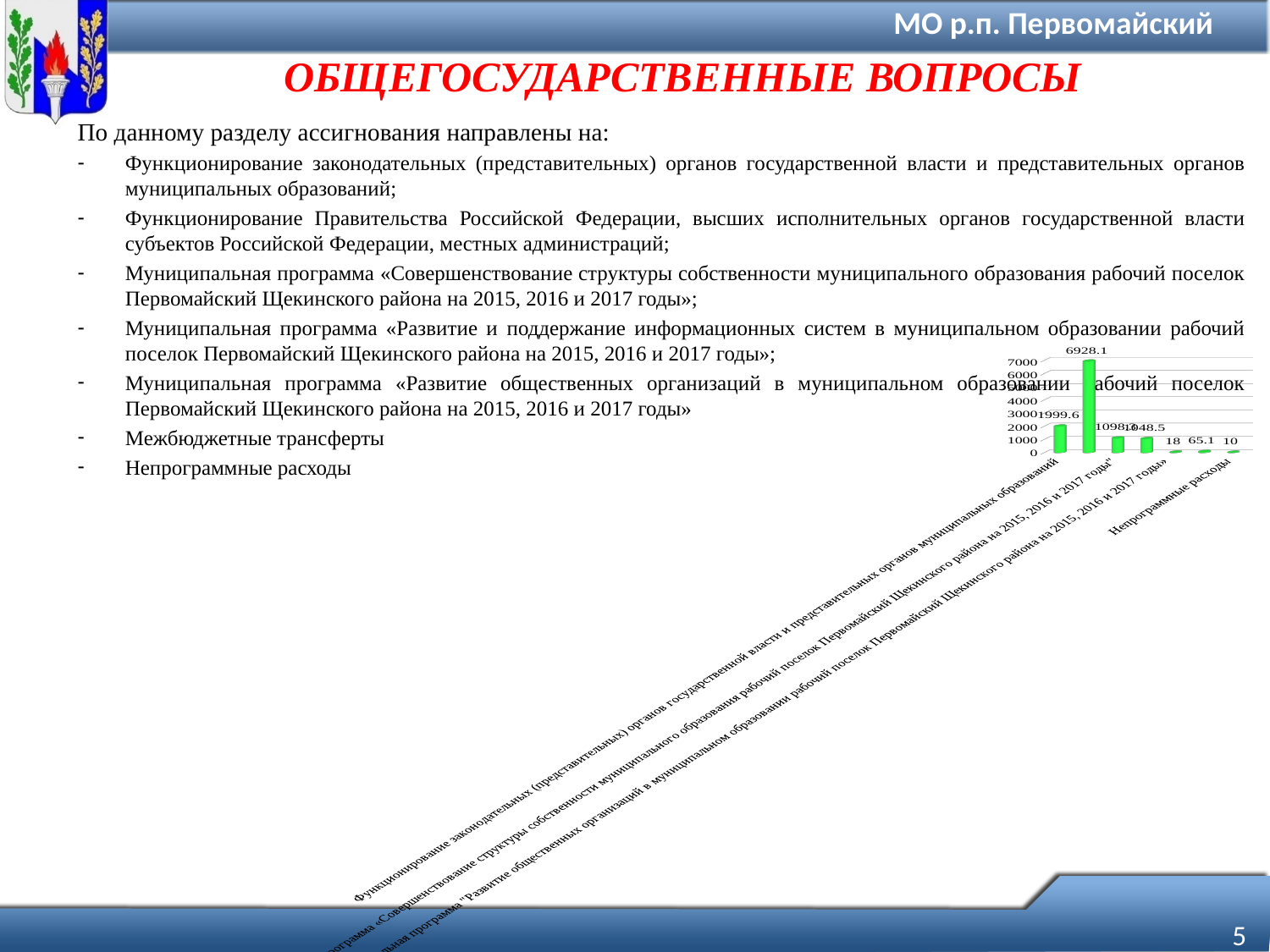
What is the difference between the bars labelled 65.1 and 18? 47.1 What is the highest value shown in the chart? 6928.1 Which is larger, the first bar (1999.6) or the second bar (6928.1)? the second bar (6928.1) What is the value for the category 'Непрограммные расходы'? 10 What is the lowest value shown in the chart? 10 How many bars are plotted in the chart? 7 What kind of chart is shown on the slide? bar chart What colour are the bars in the chart? green What is the difference between the highest value (6928.1) and the first bar's value (1999.6)? 4928.5 What is the value of the first bar in the chart? 1999.6 Is the value of the second bar greater or less than 6000? greater Is the value of the first bar greater or less than 3000? less